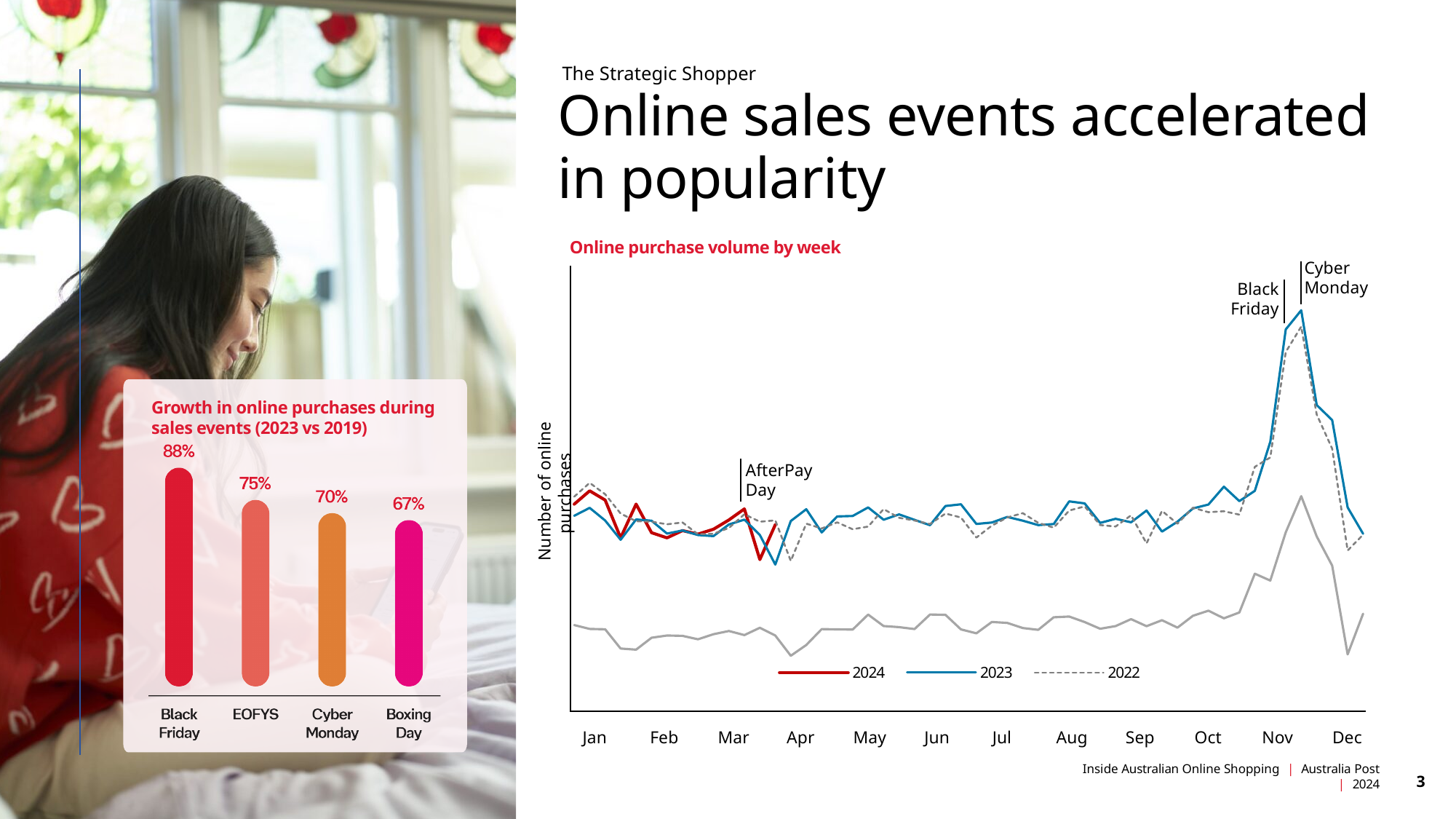
How many sales events are shown in the 'Growth in online purchases during sales events (2023 vs 2019)' chart? 4 In the 'Online purchase volume by week' chart, which series is drawn as a dashed line? 2022 In the 'Growth in online purchases during sales events (2023 vs 2019)' chart, what is the value for Black Friday? 88% What kind of chart is the 'Growth in online purchases during sales events (2023 vs 2019)' chart? Bar chart In the 'Growth in online purchases during sales events (2023 vs 2019)' chart, which is larger, the value for EOFYS or the value for Boxing Day? EOFYS In the 'Growth in online purchases during sales events (2023 vs 2019)' chart, which sales event has the highest growth? Black Friday In the 'Growth in online purchases during sales events (2023 vs 2019)' chart, what is the difference between the Black Friday and EOFYS values? 13% In the 'Growth in online purchases during sales events (2023 vs 2019)' chart, which sales event has the lowest growth? Boxing Day In the 'Online purchase volume by week' chart, in which month does the 2023 line reach its peak? Nov How many series does the legend of the 'Online purchase volume by week' chart list? 3 What kind of chart is the 'Online purchase volume by week' chart? Line chart In the 'Growth in online purchases during sales events (2023 vs 2019)' chart, what is the value for Cyber Monday? 70%